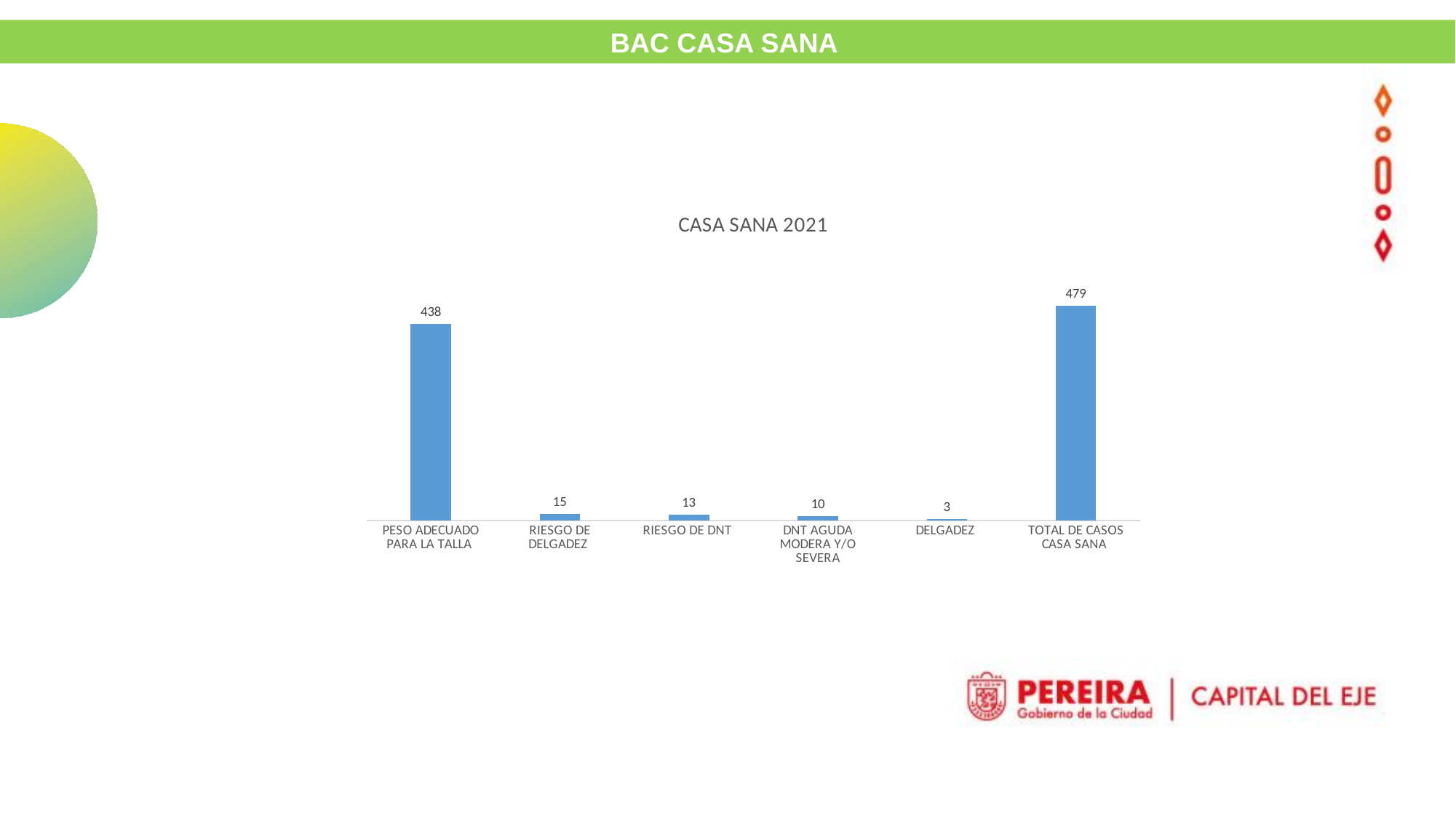
What is the value for TOTAL DE CASOS CASA SANA? 479 What kind of chart is shown on the slide? Bar chart What is the difference between TOTAL DE CASOS CASA SANA and PESO ADECUADO PARA LA TALLA? 41 How many categories are shown on the x axis? 6 Which is larger, the value for RIESGO DE DNT or the value for DELGADEZ? RIESGO DE DNT Which category has the lowest value? DELGADEZ What is the value for DNT AGUDA MODERA Y/O SEVERA? 10 Which category has the highest value? TOTAL DE CASOS CASA SANA What is the value for RIESGO DE DELGADEZ? 15 What is the difference between RIESGO DE DELGADEZ and RIESGO DE DNT? 2 What is the title of the chart? CASA SANA 2021 What is the value for PESO ADECUADO PARA LA TALLA? 438